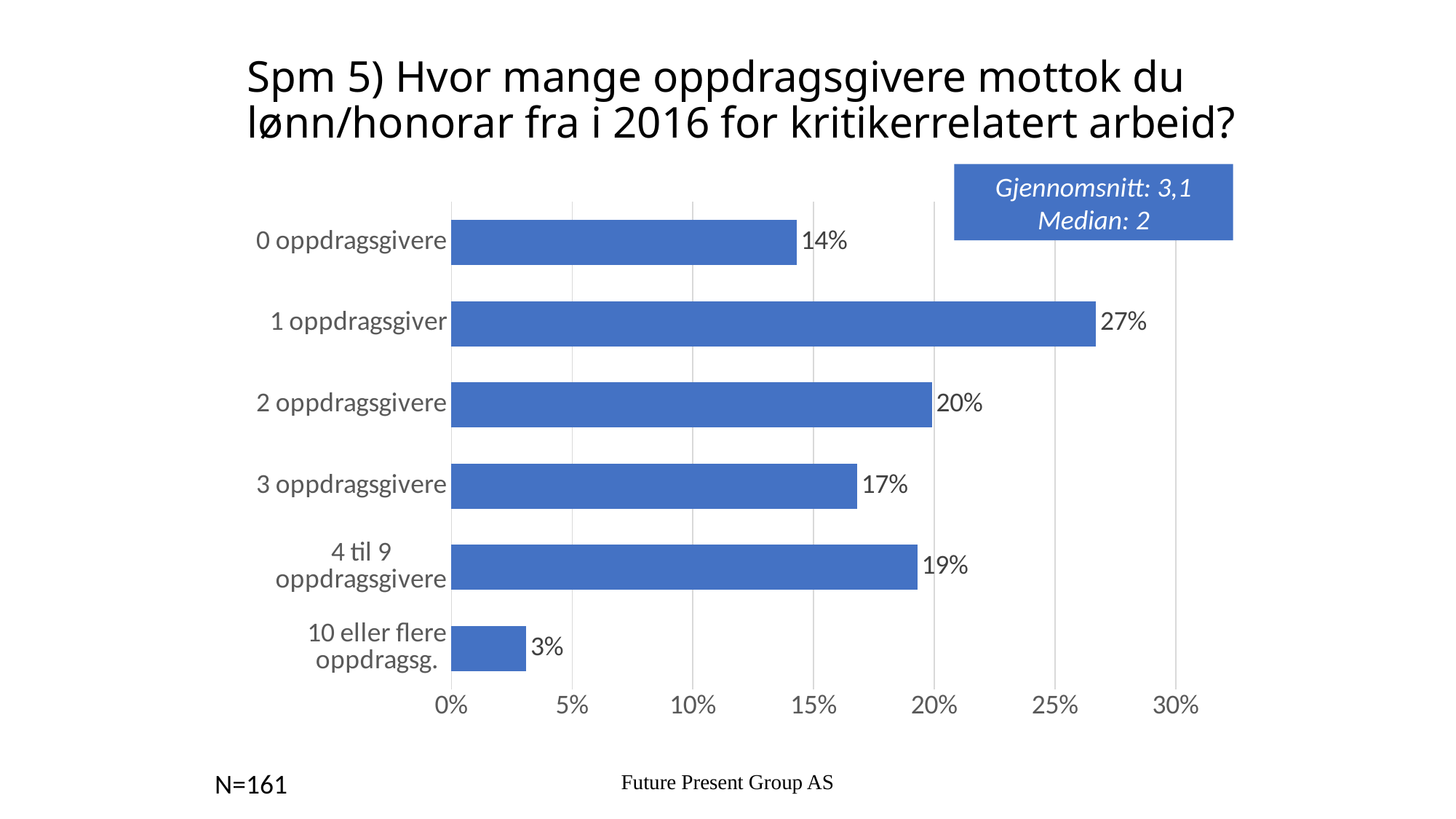
What is the average (Gjennomsnitt) stated in the box on the chart? 3,1 What is the difference between the values for "1 oppdragsgiver" and "2 oppdragsgivere"? 7% Is the value for "2 oppdragsgivere" greater or less than 15%? greater What kind of chart is shown on the slide? bar chart Which is larger, the value for "3 oppdragsgivere" or "4 til 9 oppdragsgivere"? 4 til 9 oppdragsgivere What is the median (Median) stated in the box on the chart? 2 What is the value for "1 oppdragsgiver"? 27% How many categories are shown in the chart? 6 Which category has the lowest value? 10 eller flere oppdragsg. What is the value for "0 oppdragsgivere"? 14% Which category has the highest value? 1 oppdragsgiver What is the value for "10 eller flere oppdragsg."? 3%